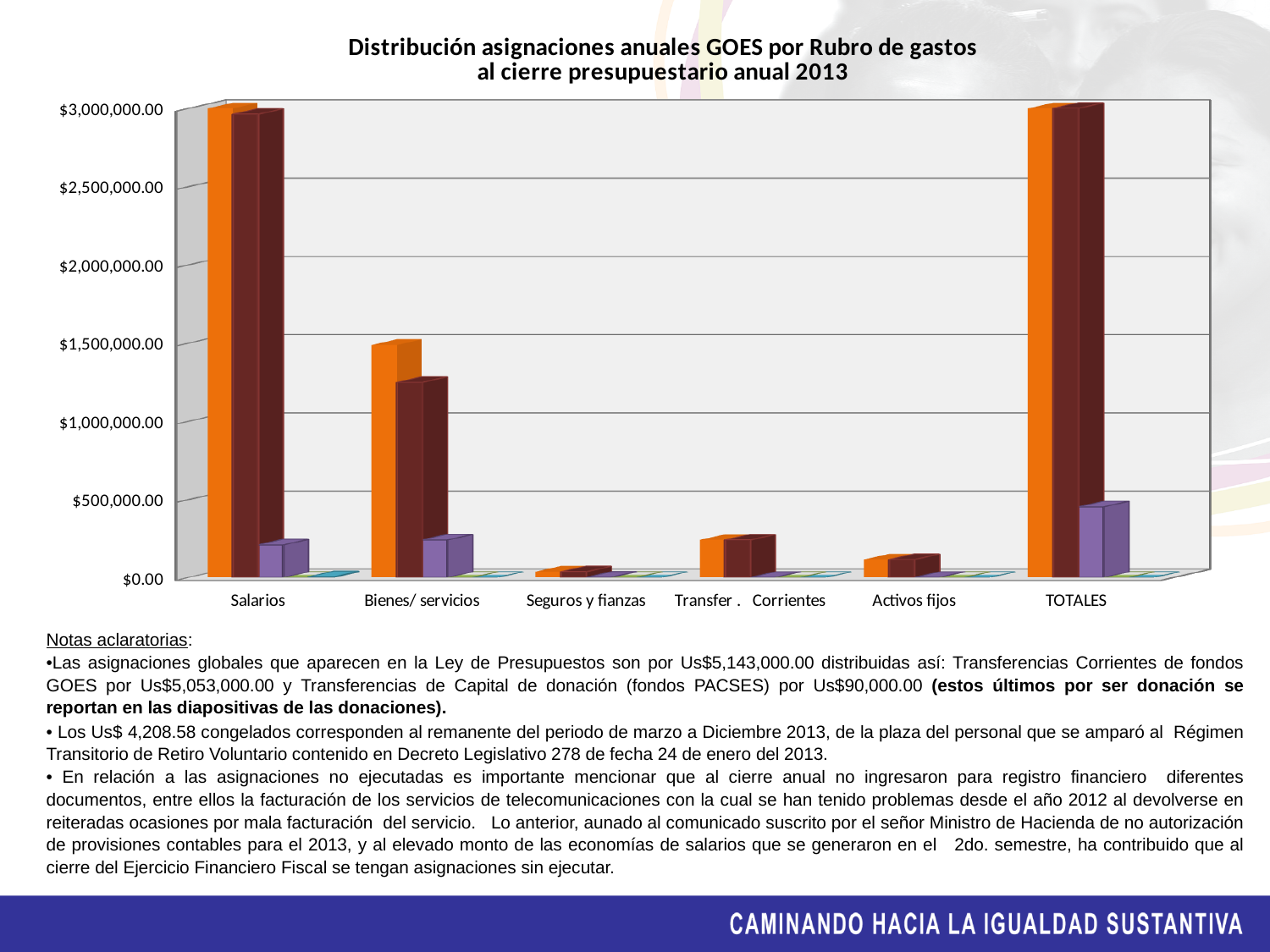
Which category has the lowest orange bar in the chart? Seguros y fianzas What is the title of the chart? Distribución asignaciones anuales GOES por Rubro de gastos al cierre presupuestario anual 2013 Which category is plotted last (rightmost) on the x axis of the chart? TOTALES What kind of chart is shown on the slide? bar chart Is the value of the orange bar for Activos fijos greater or less than $500,000.00? less How many expense categories are shown along the x axis of the chart? 6 Is the value of the purple bar for Salarios greater or less than $500,000.00? less Is the orange bar for Bienes/ servicios taller than the orange bar for Transfer. Corrientes? Yes Which has the taller orange bar, Salarios or Activos fijos? Salarios Is the value of the dark red bar for Bienes/ servicios greater or less than $1,000,000.00? greater